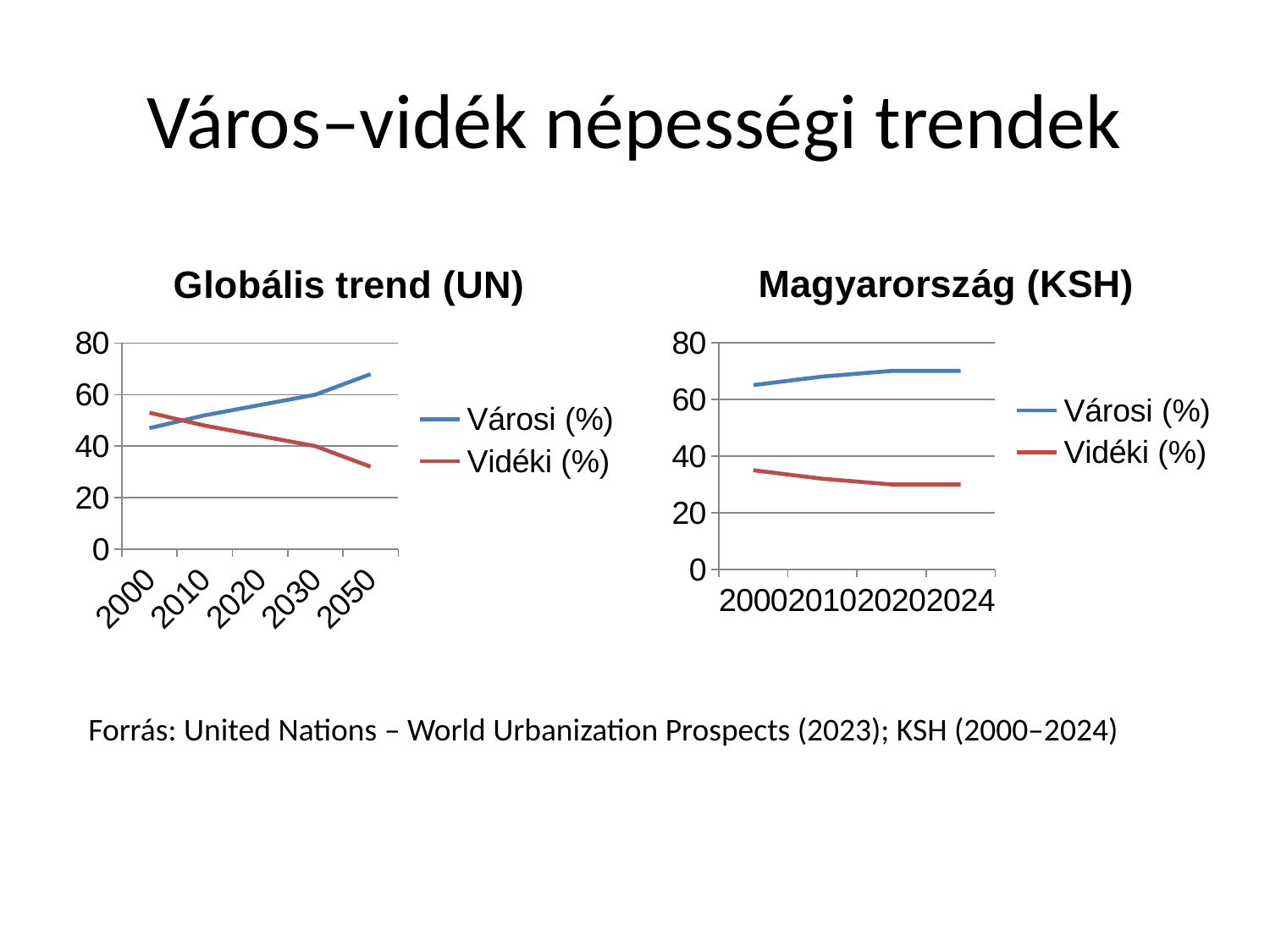
How many points are plotted along the x axis of the 'Globális trend (UN)' chart? 5 In the 'Globális trend (UN)' chart, is the Városi (%) value for 2050 greater or less than 60? greater How many series does the legend of the 'Magyarország (KSH)' chart list? 2 In the 'Globális trend (UN)' chart, which series has the larger value in 2000, Városi (%) or Vidéki (%)? Vidéki (%) In the 'Magyarország (KSH)' chart, is the Városi (%) value for 2000 greater or less than 60? greater In the 'Magyarország (KSH)' chart, which series has the larger value in 2024, Városi (%) or Vidéki (%)? Városi (%) What kind of chart is the 'Globális trend (UN)' chart? line chart In the 'Globális trend (UN)' chart, does the Vidéki (%) line rise or fall from 2000 to 2050? fall In the 'Globális trend (UN)' chart, is the Vidéki (%) value for 2050 greater or less than 40? less How many points are plotted along the x axis of the 'Magyarország (KSH)' chart? 4 In the 'Globális trend (UN)' chart, does the Városi (%) line rise or fall from 2000 to 2050? rise In the 'Magyarország (KSH)' chart, does the Vidéki (%) line rise or fall from 2000 to 2024? fall